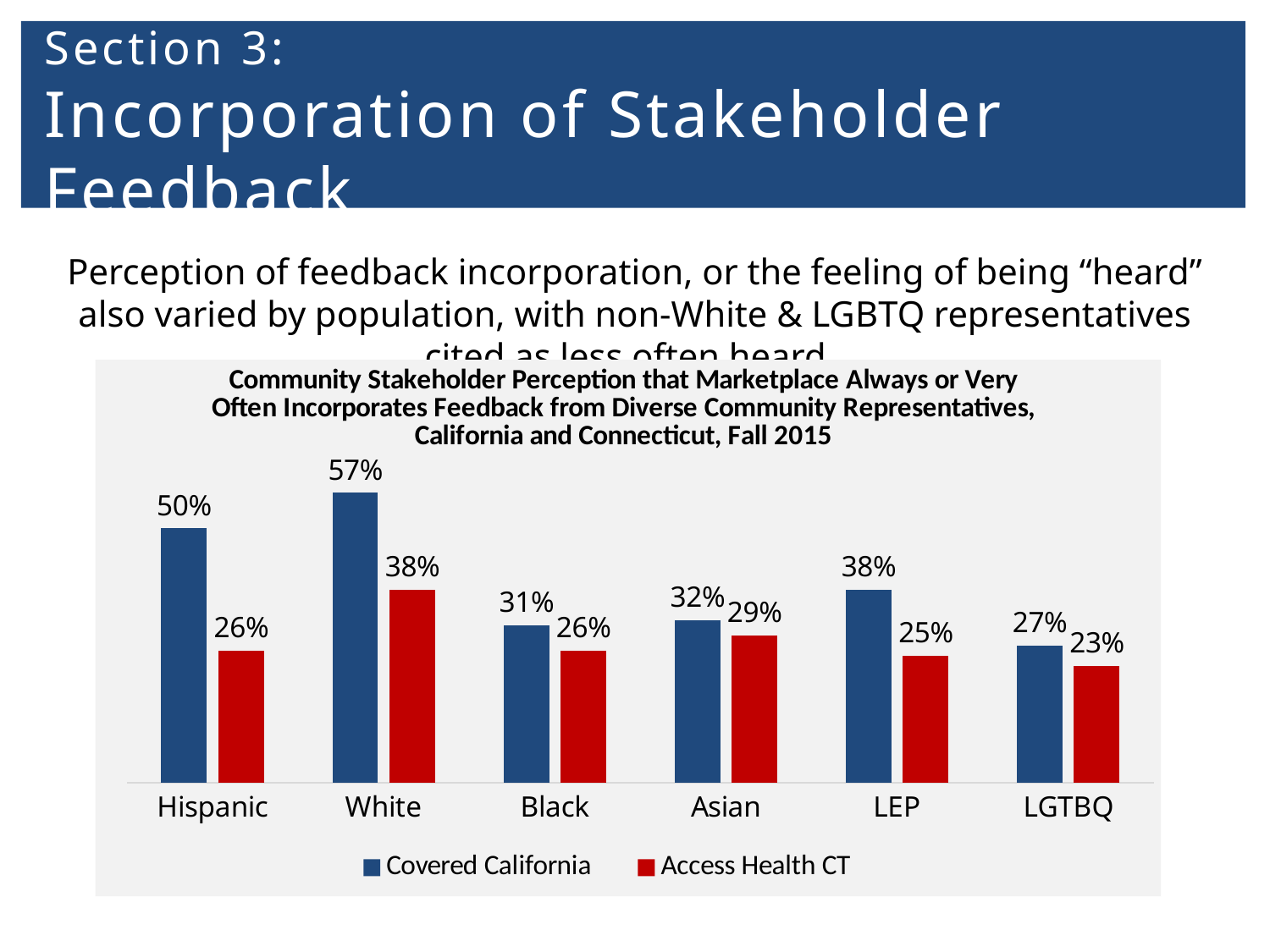
What is the Covered California value for Hispanic? 50% What is the Access Health CT value for LGTBQ? 23% How many categories are shown on the x axis? 6 Which category has the lowest Access Health CT value? LGTBQ What is the Access Health CT value for White? 38% Which category has the highest Covered California value? White Which is larger for Asian: the Covered California value or the Access Health CT value? Covered California What kind of chart is shown on the slide? Bar chart What is the difference between the Covered California and Access Health CT values for Hispanic? 24% Which colour represents Access Health CT in the chart? Red What is the Covered California value for LEP? 38% How many series does the legend list? 2